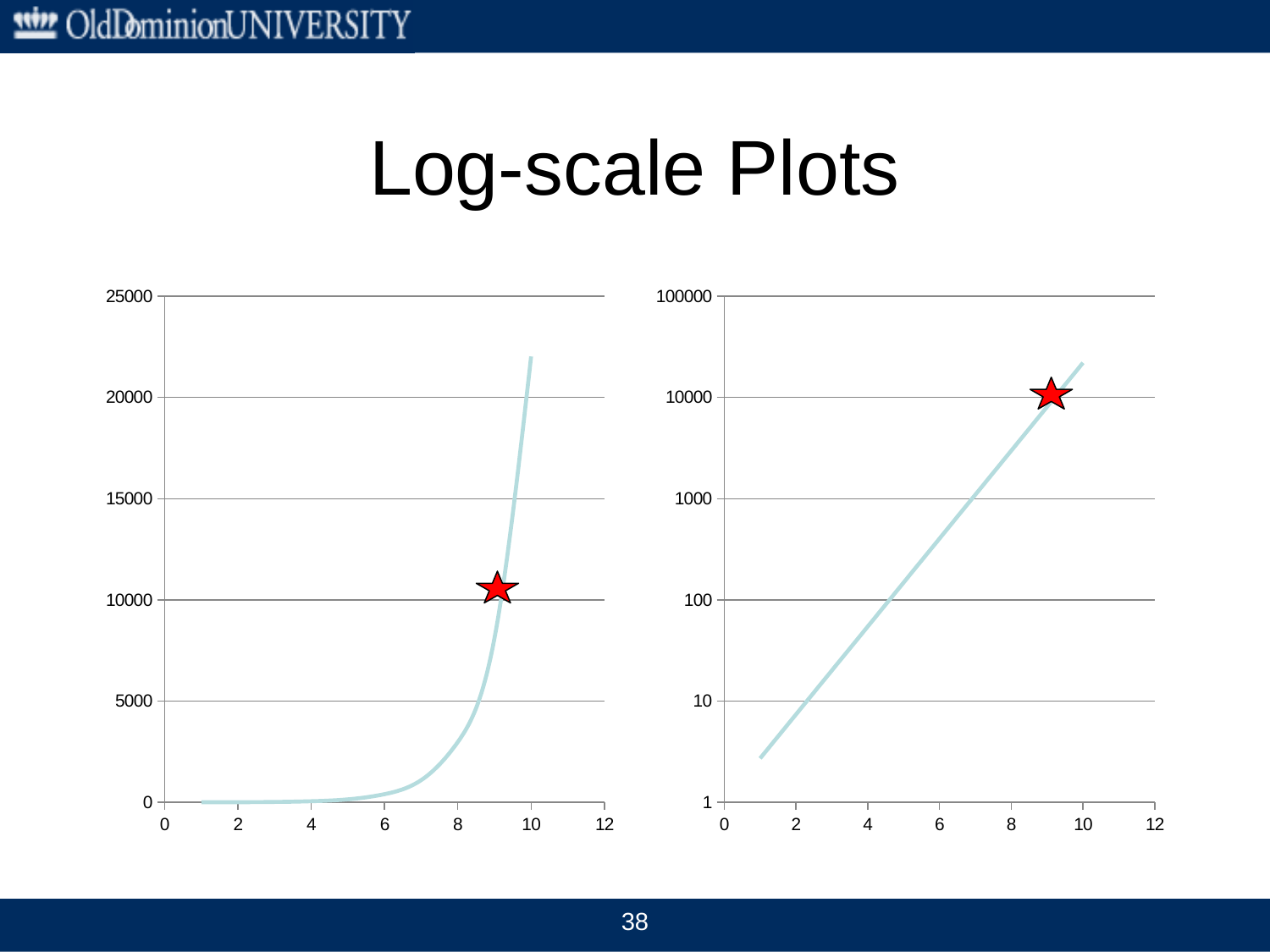
What is the highest value labelled on the y-axis of the left chart? 25000 In the right chart, is the value at x = 4 greater or less than 100? less In the left chart, do the values rise or fall as x increases? rise In the left chart, is the value at x = 6 greater or less than 5000? less What kind of chart is the right chart on the slide? line chart In the right chart, is the value at x = 6 greater or less than 100? greater In the right chart, do the values rise or fall as x increases? rise What kind of chart is the left chart on the slide? line chart What is the highest value labelled on the y-axis of the right chart? 100000